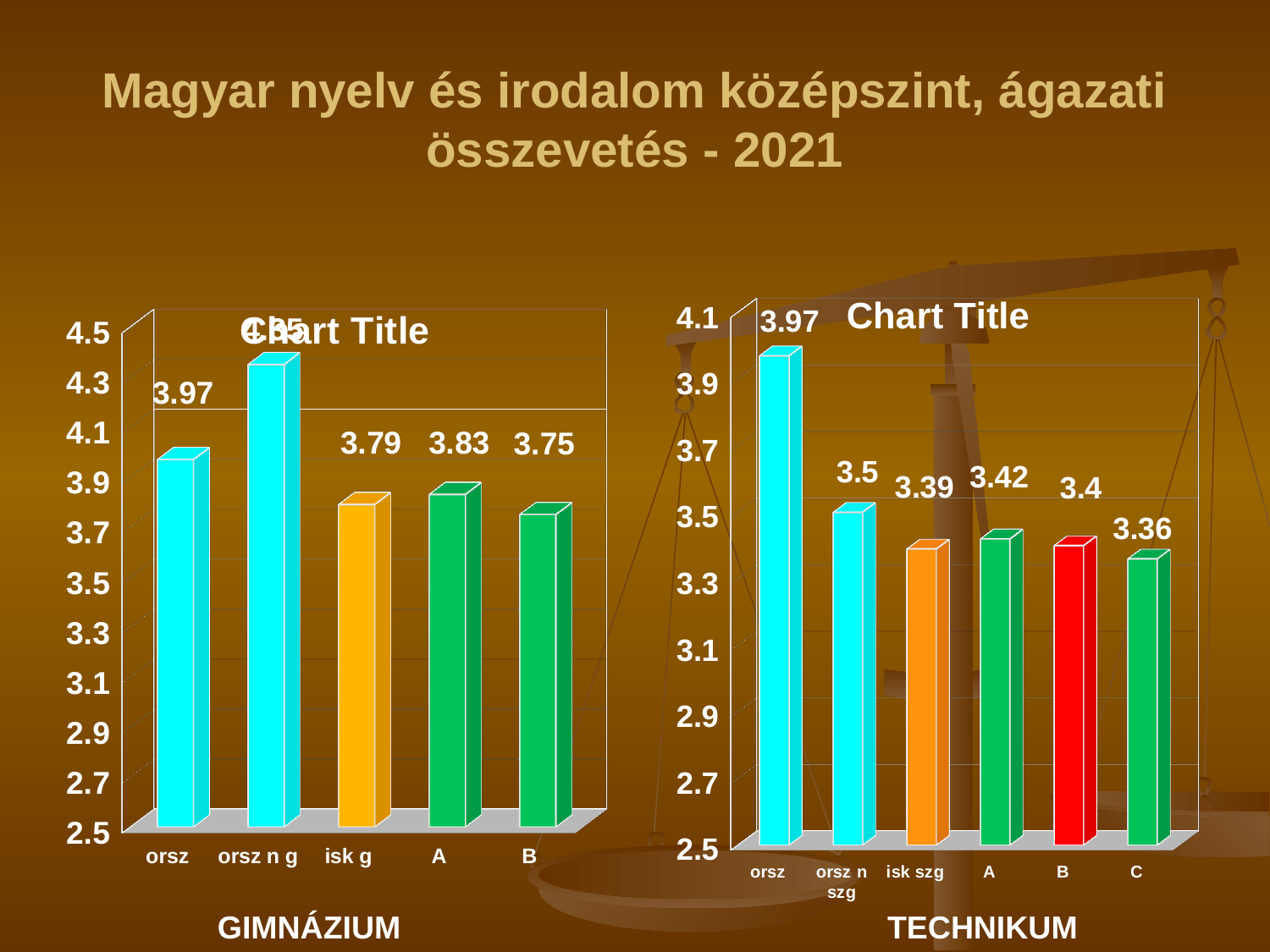
In the left chart (GIMNÁZIUM), what is the value for A? 3.83 In the right chart (TECHNIKUM), what is the value for orsz n szg? 3.5 In the right chart (TECHNIKUM), how many bars are plotted? 6 In the left chart (GIMNÁZIUM), which category has the highest value? orsz n g In the left chart (GIMNÁZIUM), which category has the lowest value? B In the left chart (GIMNÁZIUM), what is the difference between the values for A and B? 0.08 In the left chart (GIMNÁZIUM), what is the value for isk g? 3.79 In the right chart (TECHNIKUM), what is the value for C? 3.36 In the left chart (GIMNÁZIUM), how many bars are plotted? 5 What type of chart is the right chart (TECHNIKUM)? bar chart In the right chart (TECHNIKUM), what is the difference between the values for orsz and orsz n szg? 0.47 In the right chart (TECHNIKUM), which category has the highest value? orsz